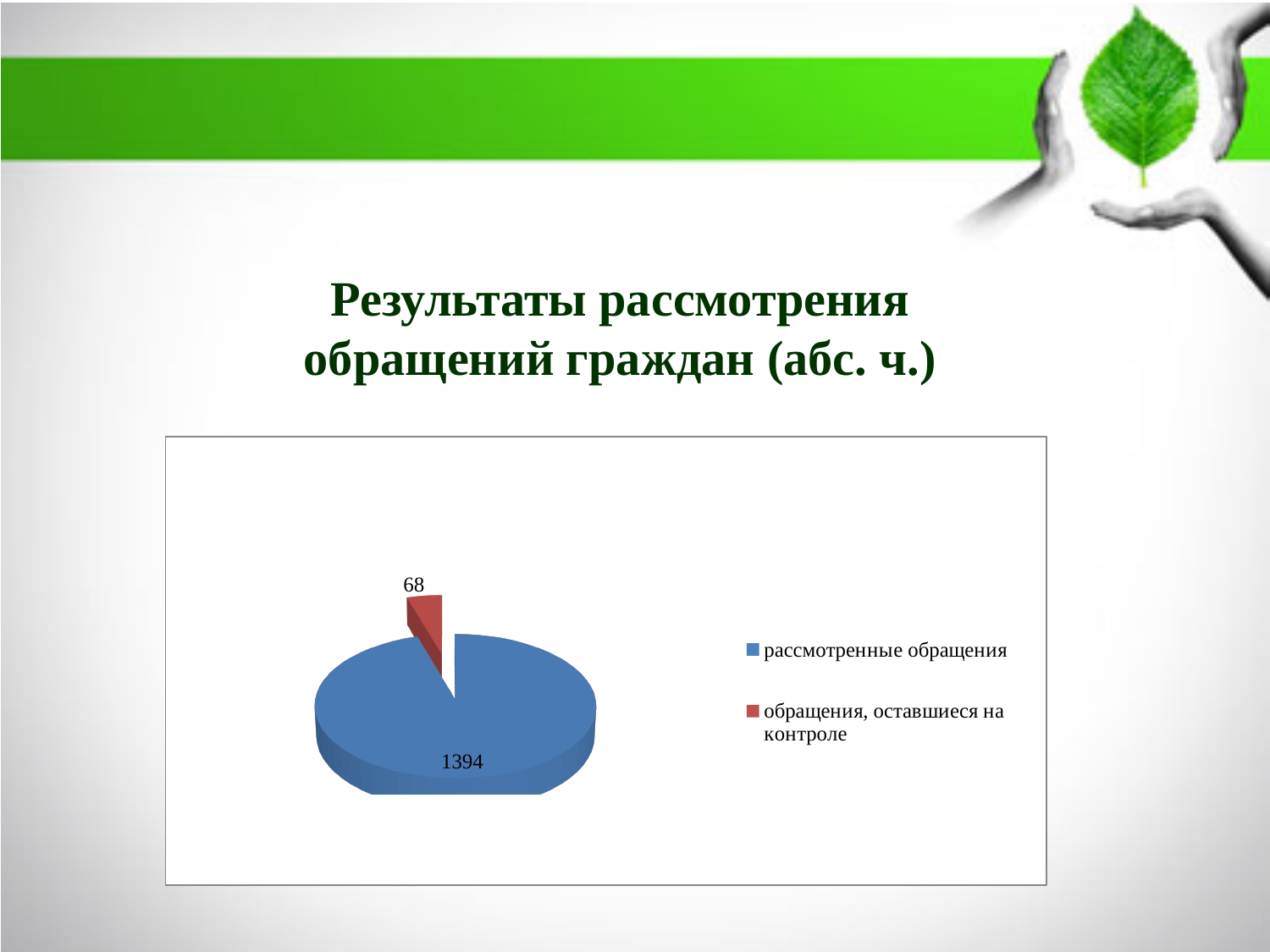
What colour is the slice for "обращения, оставшиеся на контроле"? red What type of chart is shown on the slide? pie chart What is the title of the slide above the chart? Результаты рассмотрения обращений граждан (абс. ч.) Which category has the smallest slice of the pie? обращения, оставшиеся на контроле What is the value for "обращения, оставшиеся на контроле"? 68 How many slices does the pie chart have? 2 How many entries does the legend list? 2 What is the value for "рассмотренные обращения"? 1394 What is the total of all slices in the pie chart? 1462 Which category has the largest slice of the pie? рассмотренные обращения What is the difference between the values for "рассмотренные обращения" and "обращения, оставшиеся на контроле"? 1326 Which is larger: "рассмотренные обращения" or "обращения, оставшиеся на контроле"? рассмотренные обращения